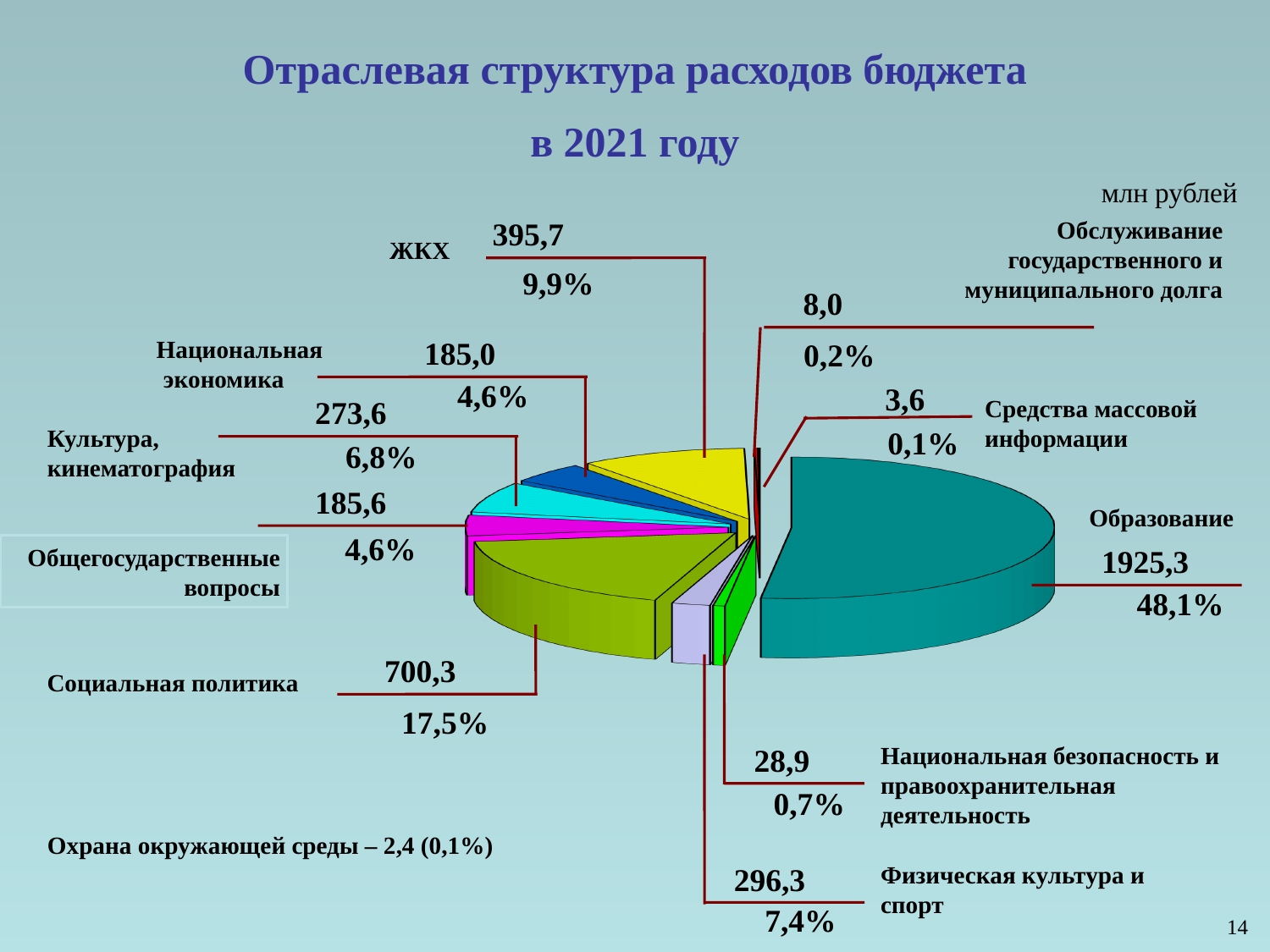
What is the value for Физическая культура и спорт? 296,3 What is the difference between ЖКХ and Физическая культура и спорт? 99,4 What percentage share does ЖКХ have? 9,9% Which is larger: Культура, кинематография or Национальная экономика? Культура, кинематография What is the value for Образование, in million rubles? 1925,3 What is the value for Социальная политика? 700,3 What kind of chart is shown on the slide? Pie chart What share of the pie does Образование take? 48,1% In what units are the values on the chart given? млн рублей Which category has the smallest value? Охрана окружающей среды What is the difference between Образование and Социальная политика, in million rubles? 1225,0 Which category has the largest share of the budget expenditure? Образование